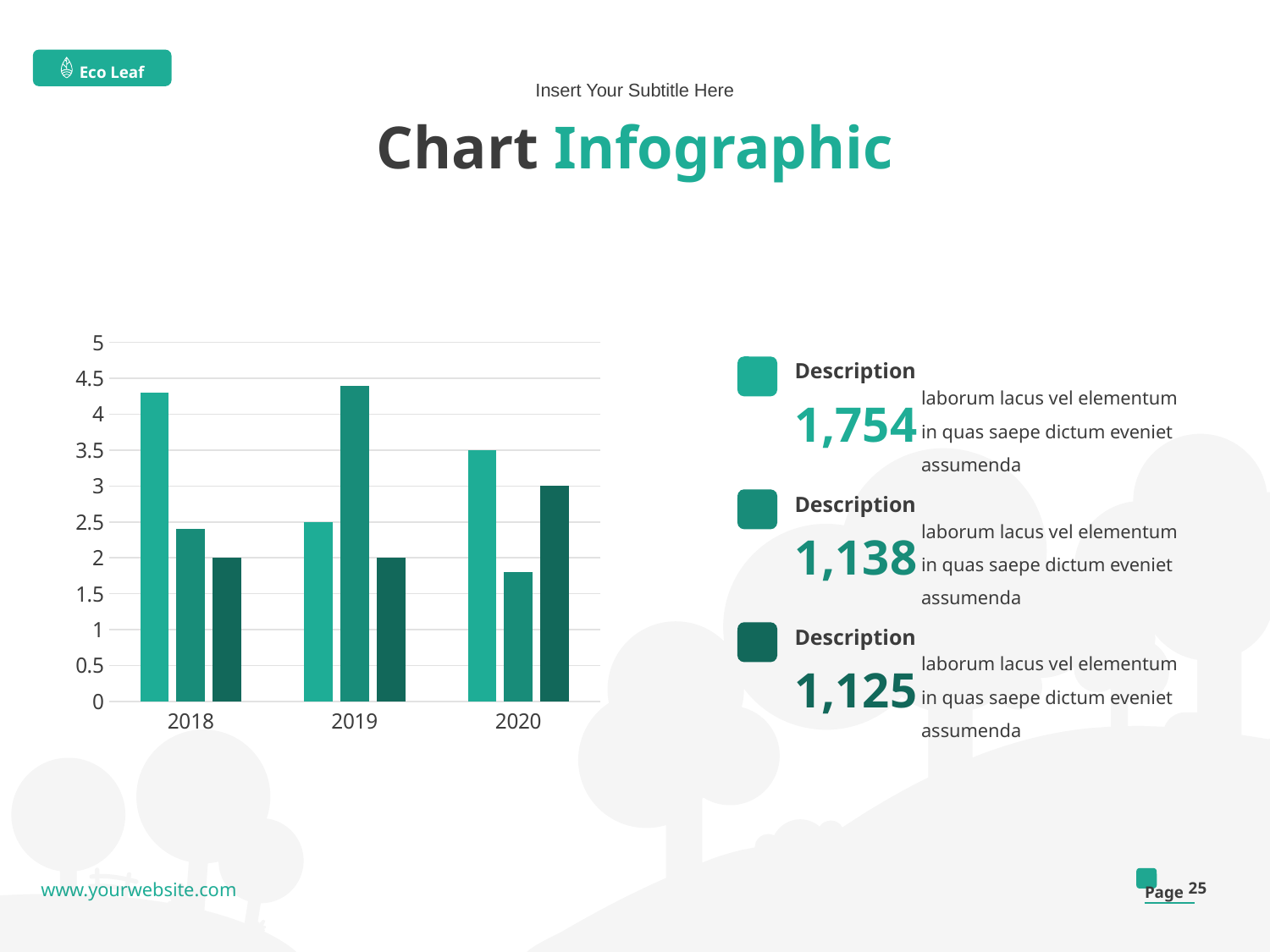
Which of the three bars for 2019 is the highest: the first, middle or last? middle How many years are shown on the x axis of the chart? 3 What is the value of the darkest green bar for 2018? 2 How many bars are plotted for each year in the chart? 3 Is the value of the middle bar for 2020 greater or less than 2? less What kind of chart is shown on the slide? bar chart Is the value of the first (lightest green) bar for 2018 greater or less than 4? greater What is the value of the darkest green bar for 2020? 3 What is the value of the lightest green (first) bar for 2019? 2.5 What is the value of the lightest green (first) bar for 2020? 3.5 Which is larger: the darkest green bar for 2018 or the darkest green bar for 2020? 2020 What is the highest value shown on the chart's vertical axis? 5